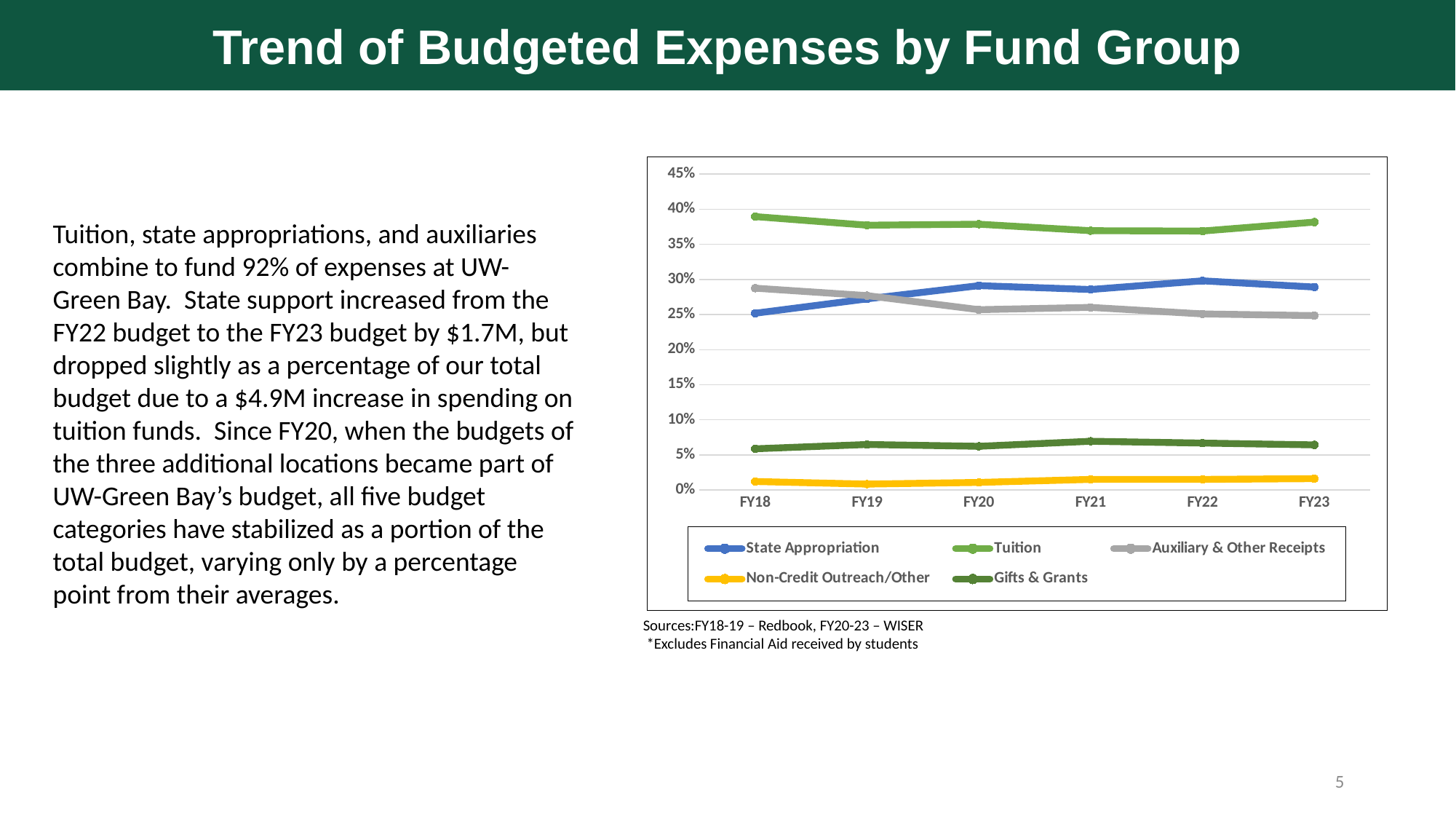
Does the State Appropriation line rise or fall from FY18 to FY20? rise Is the value for Tuition in FY18 greater or less than 35%? greater In FY18, which is larger: State Appropriation or Auxiliary & Other Receipts? Auxiliary & Other Receipts Is the value for State Appropriation in FY18 greater or less than 30%? less Which fund group has the highest share in FY23? Tuition How many series does the chart's legend list? 5 Which series is drawn in yellow in the chart? Non-Credit Outreach/Other In FY20, which is larger: State Appropriation or Auxiliary & Other Receipts? State Appropriation Is the value for Gifts & Grants in FY21 greater or less than 10%? less How many fiscal years are plotted along the x axis? 6 Which fund group has the lowest share in FY18? Non-Credit Outreach/Other What kind of chart is shown on the slide? line chart